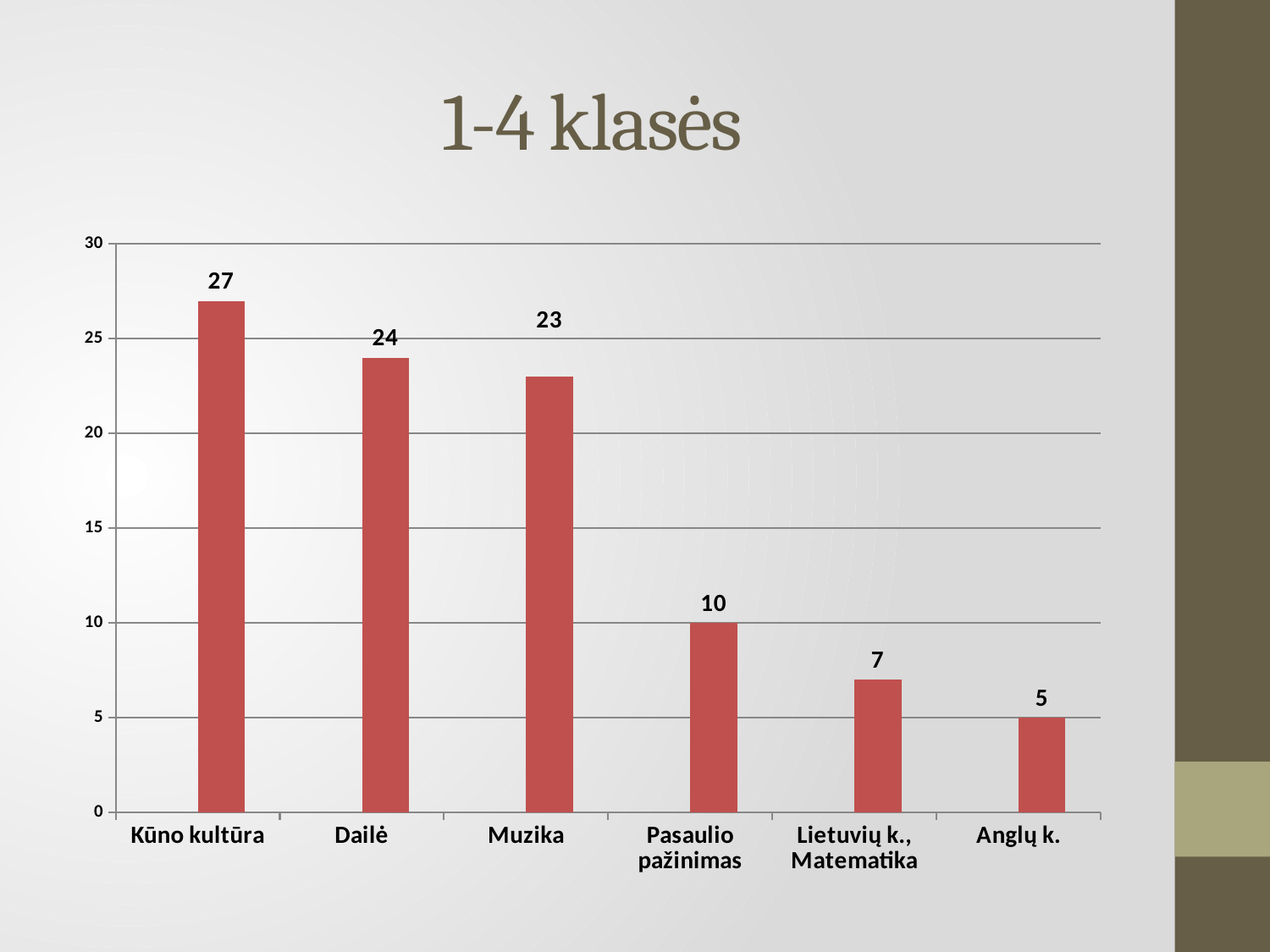
Which category has the lowest value? Anglų k. What is the difference between the values for Dailė and Muzika? 1 What kind of chart is shown on the slide? bar chart What is the title of the slide? 1-4 klasės What is the difference between the values for Kūno kultūra and Anglų k.? 22 What is the value for Pasaulio pažinimas? 10 Is the value for Dailė greater or less than 20? greater How many categories are shown on the x axis? 6 Which is larger, the value for Muzika or the value for Pasaulio pažinimas? Muzika What is the value for Kūno kultūra? 27 What is the value for Lietuvių k., Matematika? 7 Which category has the highest value? Kūno kultūra